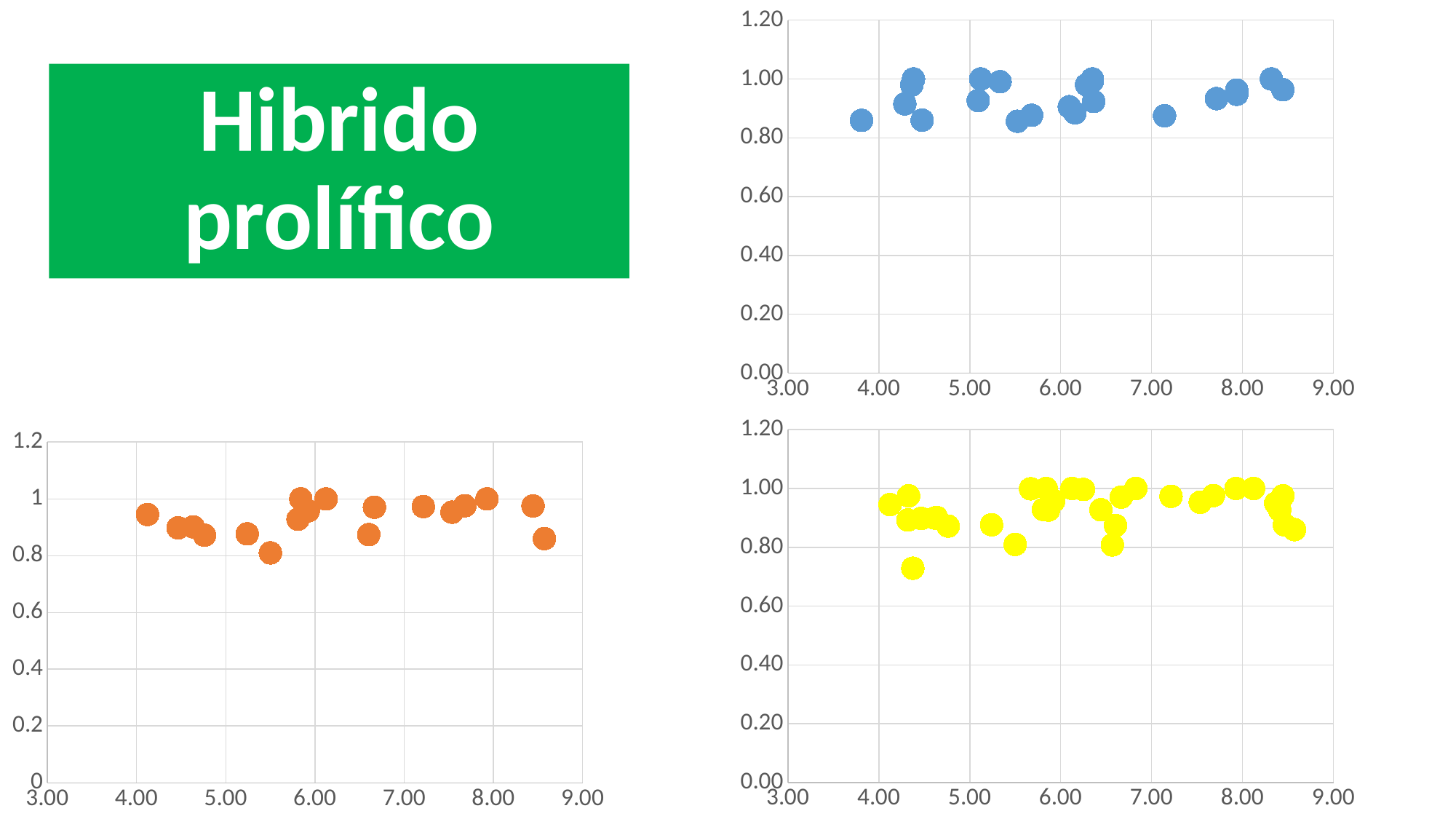
What kind of chart is the bottom-left chart with orange markers? scatter chart In the bottom-right chart with yellow markers, is the lowest plotted point greater or less than 0.80 on the vertical axis? less In the top-right chart with blue markers, are all the plotted points greater or less than 0.60 on the vertical axis? greater What is the maximum value shown on the vertical axis of the top-right chart? 1.20 In the top-right chart with blue markers, is the lowest plotted point greater or less than 0.80 on the vertical axis? greater What colour are the markers in the bottom-right chart? yellow What kind of chart is the top-right chart with blue markers? scatter chart How many charts are shown on the slide? 3